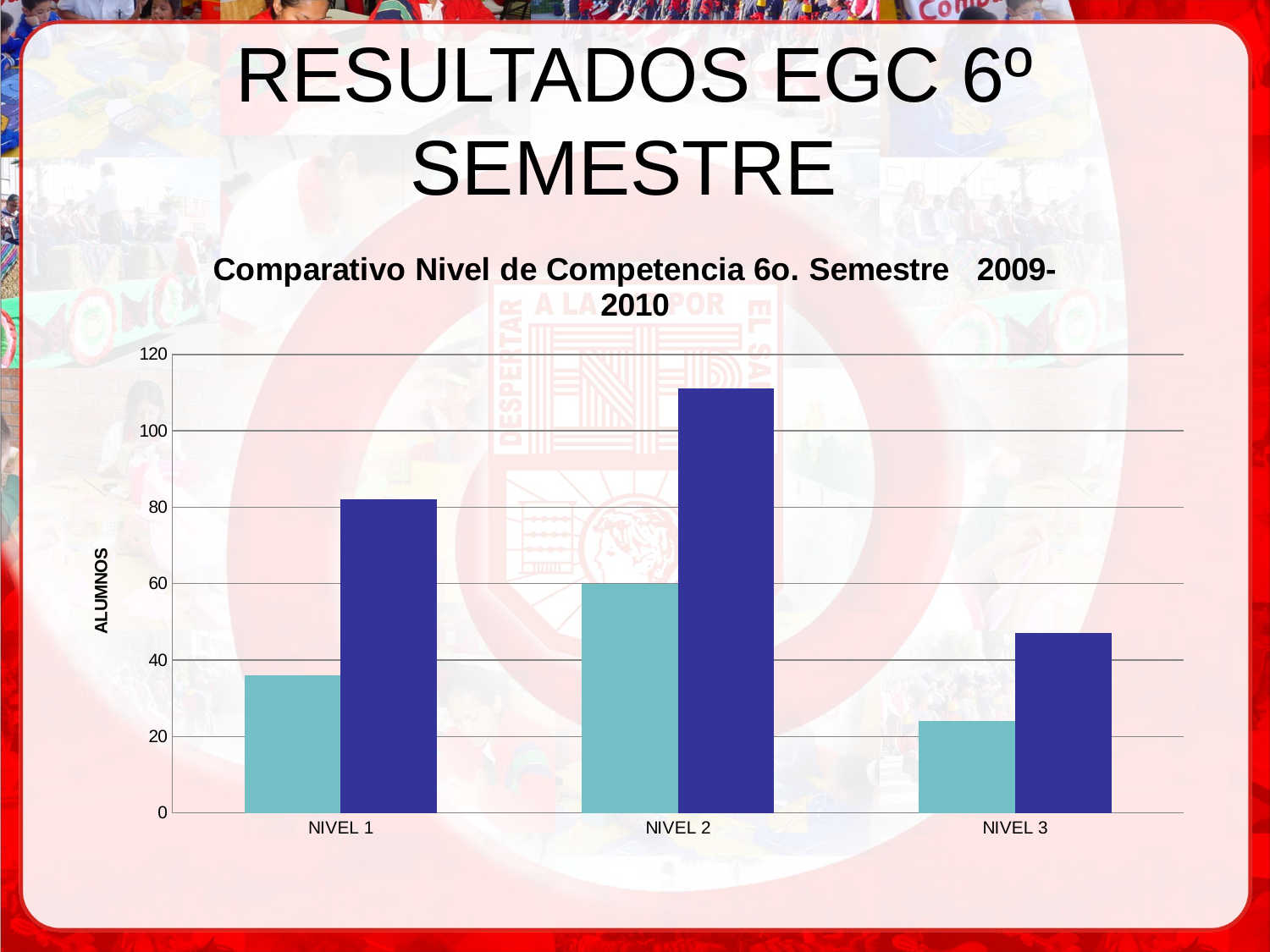
What is the title of the chart? Comparativo Nivel de Competencia 6o. Semestre 2009-2010 Which category has the shortest light blue bar? NIVEL 3 Is the dark blue bar for NIVEL 2 greater or less than 100? greater What kind of chart is shown on the slide? bar chart Is the dark blue bar for NIVEL 3 greater or less than 60? less Is the light blue bar for NIVEL 1 greater or less than 40? less What is the label of the vertical axis? ALUMNOS How many categories are shown on the x axis of the chart? 3 Which is larger, the light blue bar for NIVEL 2 or the dark blue bar for NIVEL 3? the light blue bar for NIVEL 2 Which category has the tallest dark blue bar? NIVEL 2 For NIVEL 3, which bar is taller, the light blue bar or the dark blue bar? the dark blue bar